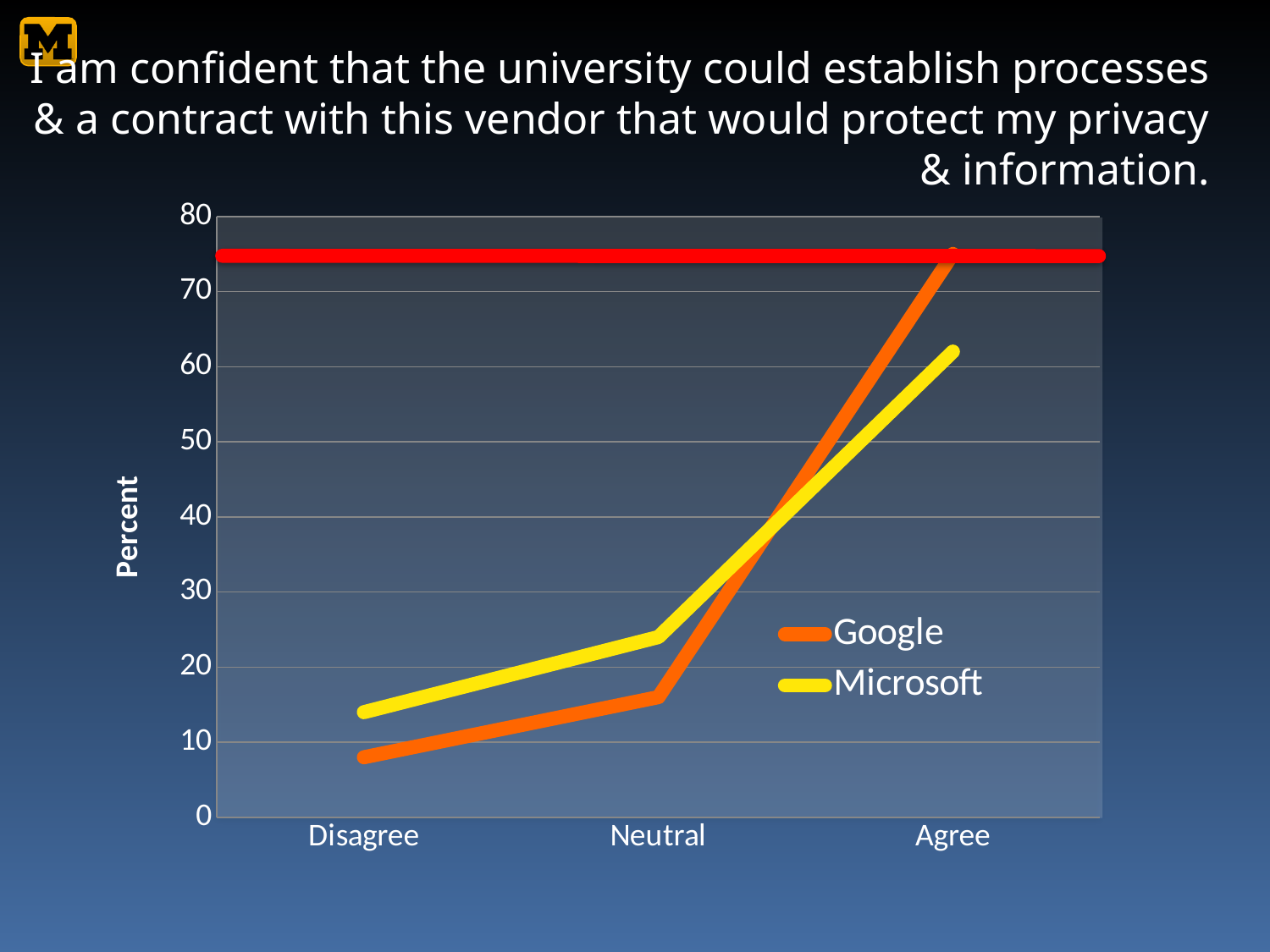
What kind of chart is shown on the slide? line chart Is the value for Google at Disagree greater or less than 10? less At Agree, which series has the larger value, Google or Microsoft? Google Which series is drawn in yellow? Microsoft At Disagree, which series has the larger value, Google or Microsoft? Microsoft How many categories are shown on the x axis? 3 Is the value for Google at Agree greater or less than 70? greater What is the title of the vertical axis? Percent Is the value for Microsoft at Neutral greater or less than 20? greater How many series does the legend list? 2 Do the values for Google rise or fall from Disagree to Agree? rise